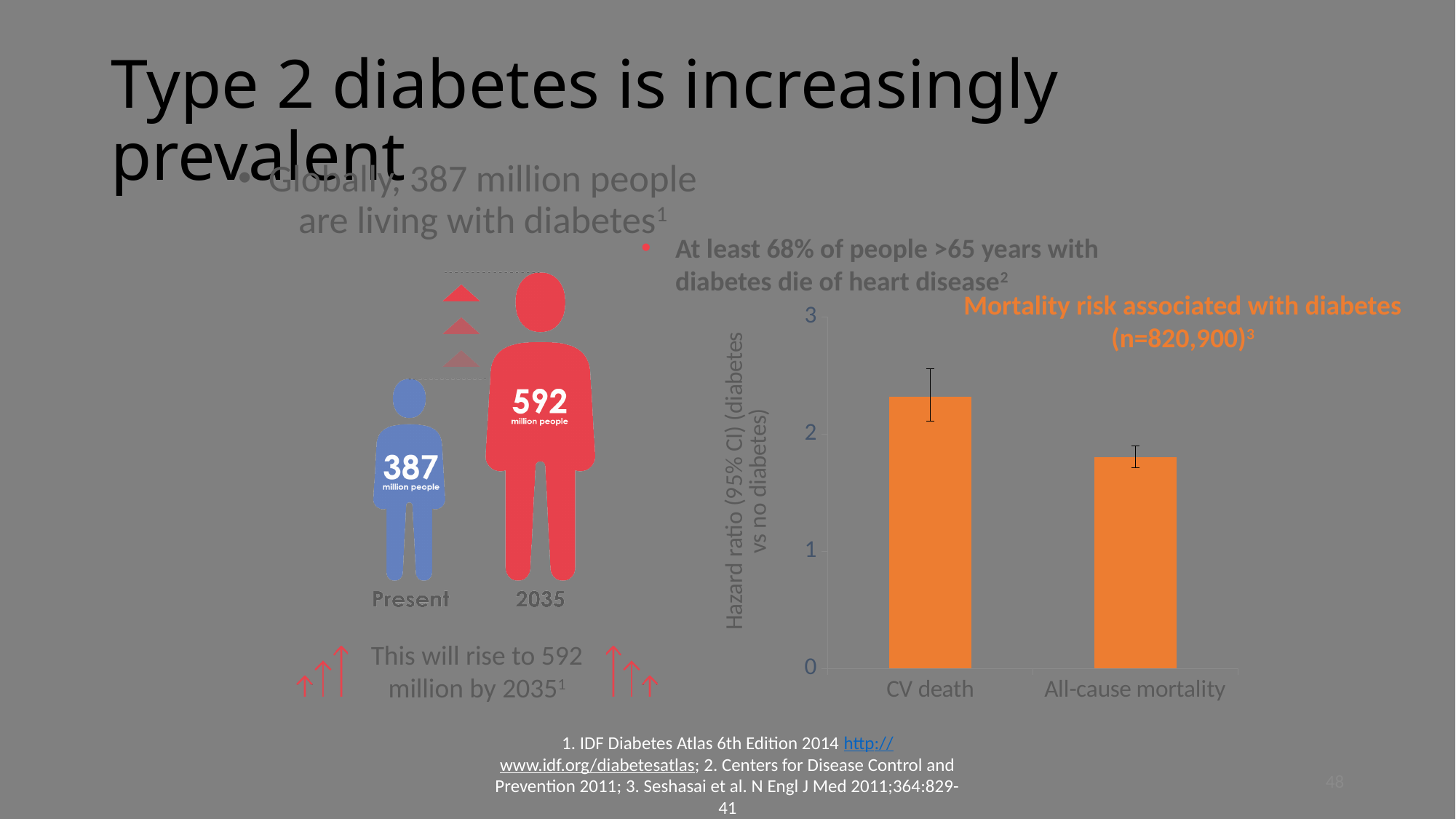
Do the bars in the 'Mortality risk associated with diabetes' chart rise or fall from left to right along the x axis? fall In the 'Mortality risk associated with diabetes' chart, is the hazard ratio for All-cause mortality greater or less than 2? less How many categories are shown on the x axis of the 'Mortality risk associated with diabetes' chart? 2 In the 'Mortality risk associated with diabetes' chart, which is larger: the hazard ratio for CV death or for All-cause mortality? CV death In the 'Mortality risk associated with diabetes' chart, is the hazard ratio for CV death greater or less than 3? less In the 'Mortality risk associated with diabetes' chart, which category has the lowest hazard ratio? All-cause mortality In the 'Mortality risk associated with diabetes' chart, which category has the highest hazard ratio? CV death What is the y-axis label of the 'Mortality risk associated with diabetes' chart? Hazard ratio (95% CI) (diabetes vs no diabetes) What kind of chart is the 'Mortality risk associated with diabetes' chart? bar chart In the 'Mortality risk associated with diabetes' chart, is the hazard ratio for All-cause mortality greater or less than 1? greater What is the sample size (n) given in the title of the bar chart? n=820,900